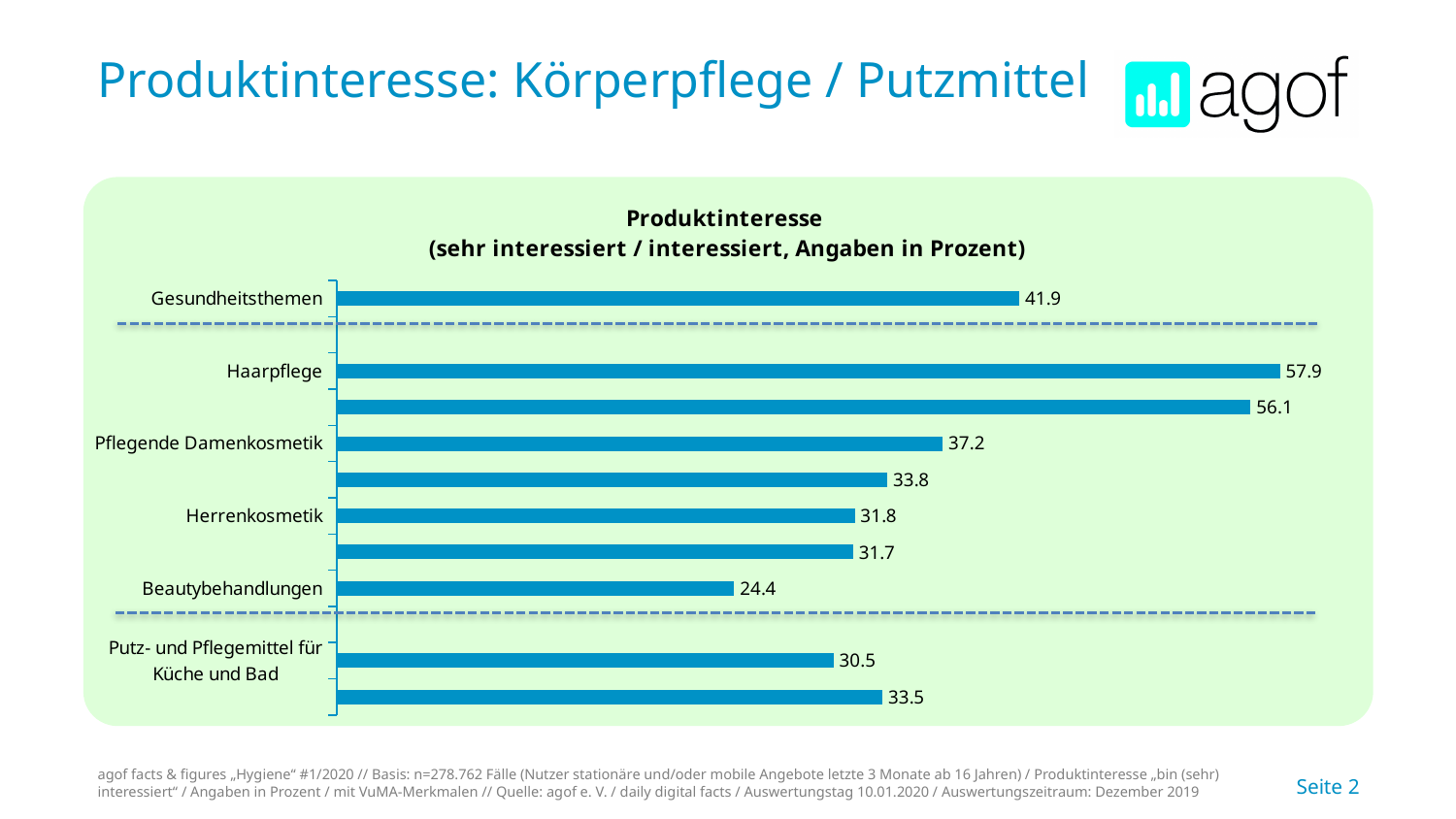
What is the first line of the chart's title? Produktinteresse Which category has the highest value? Haarpflege What is the value for Gesundheitsthemen? 41.9 How many bars are plotted in the chart? 10 Which is larger, the value for Pflegende Damenkosmetik or the value for Herrenkosmetik? Pflegende Damenkosmetik What is the value for Beautybehandlungen? 24.4 What is the difference between the values for Haarpflege and Gesundheitsthemen? 16.0 What is the value for Herrenkosmetik? 31.8 What kind of chart is shown on the slide? Bar chart What is the value for Haarpflege? 57.9 Which category has the lowest value? Beautybehandlungen What is the value for Pflegende Damenkosmetik? 37.2